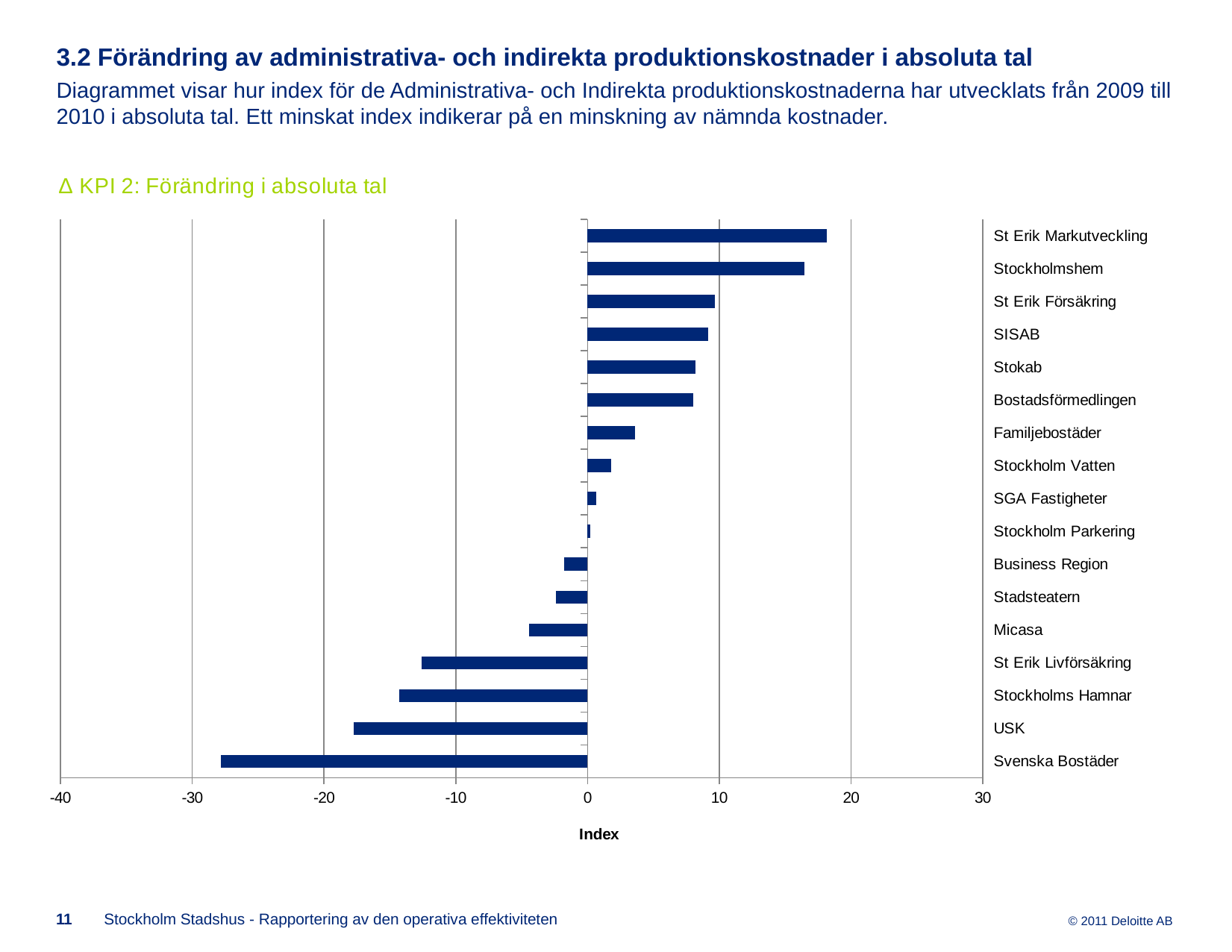
Which company has the highest value in the chart? St Erik Markutveckling What is the title of the horizontal axis? Index Is the value for USK greater or less than -10? less How many companies (categories) are plotted in the chart? 17 Is the value for Familjebostäder greater or less than 10? less Is the value for Svenska Bostäder greater or less than -20? less Which has the larger value, Stockholmshem or SISAB? Stockholmshem Which has the larger value, Micasa or St Erik Livförsäkring? Micasa Which company has the lowest value in the chart? Svenska Bostäder Do the values rise or fall going from the top category to the bottom category of the chart? fall What kind of chart is shown on the slide? bar chart